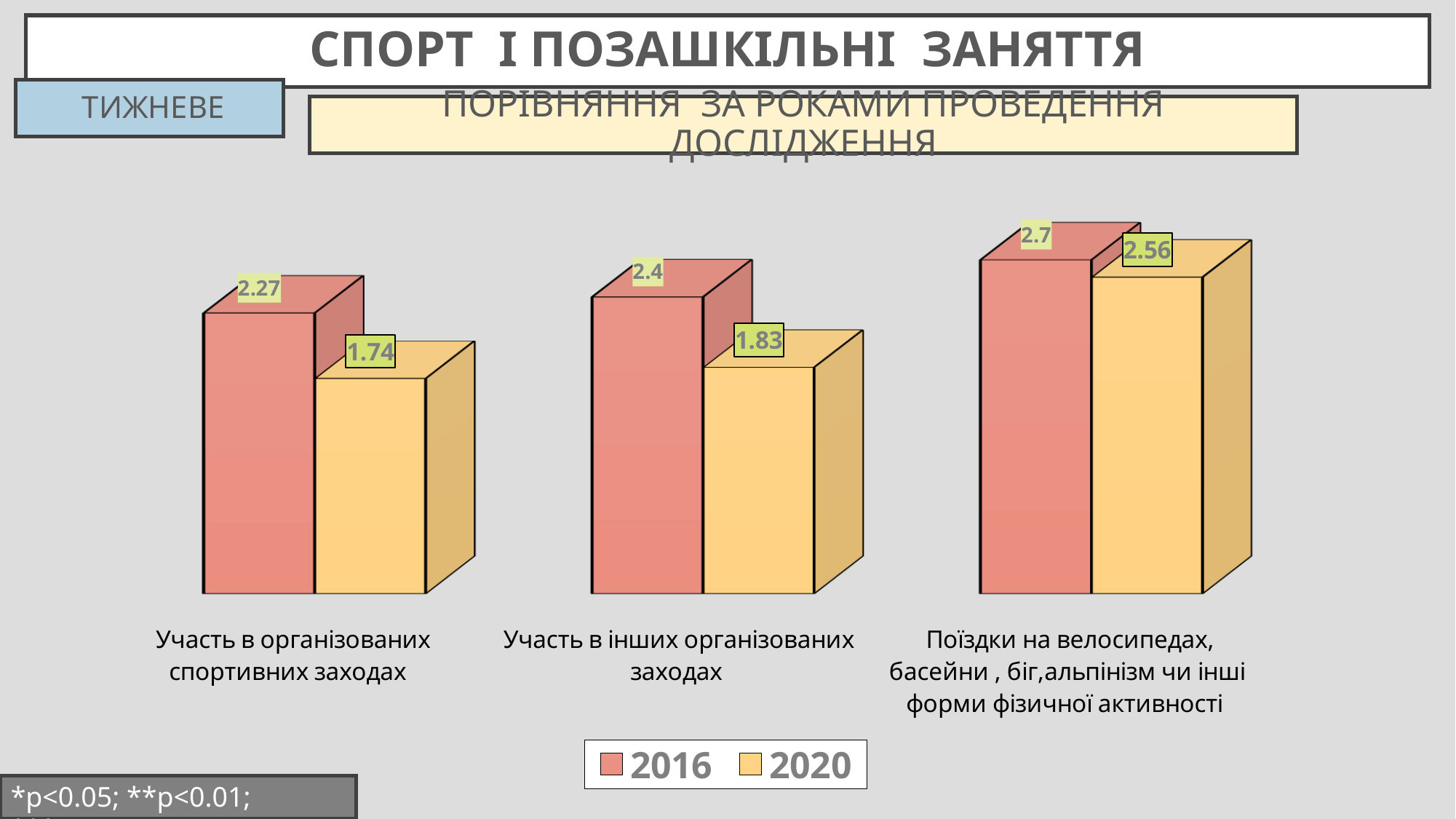
What is the value for 2020 for "Поїздки на велосипедах, басейни, біг, альпінізм чи інші форми фізичної активності"? 2.56 What is the difference between the 2016 and 2020 values for "Участь в інших організованих заходах"? 0.57 Which category has the highest value for 2016? Поїздки на велосипедах, басейни, біг, альпінізм чи інші форми фізичної активності What kind of chart is shown on the slide? Bar chart What is the difference between the 2016 and 2020 values for "Участь в організованих спортивних заходах"? 0.53 How many categories are shown on the chart? 3 Which is larger for "Поїздки на велосипедах, басейни, біг, альпінізм чи інші форми фізичної активності": the 2016 value or the 2020 value? 2016 How many series does the legend list? 2 What is the value for 2016 for "Участь в організованих спортивних заходах"? 2.27 Which category has the lowest value for 2020? Участь в організованих спортивних заходах Which colour represents the 2020 series in the legend? Yellow What is the value for 2020 for "Участь в інших організованих заходах"? 1.83